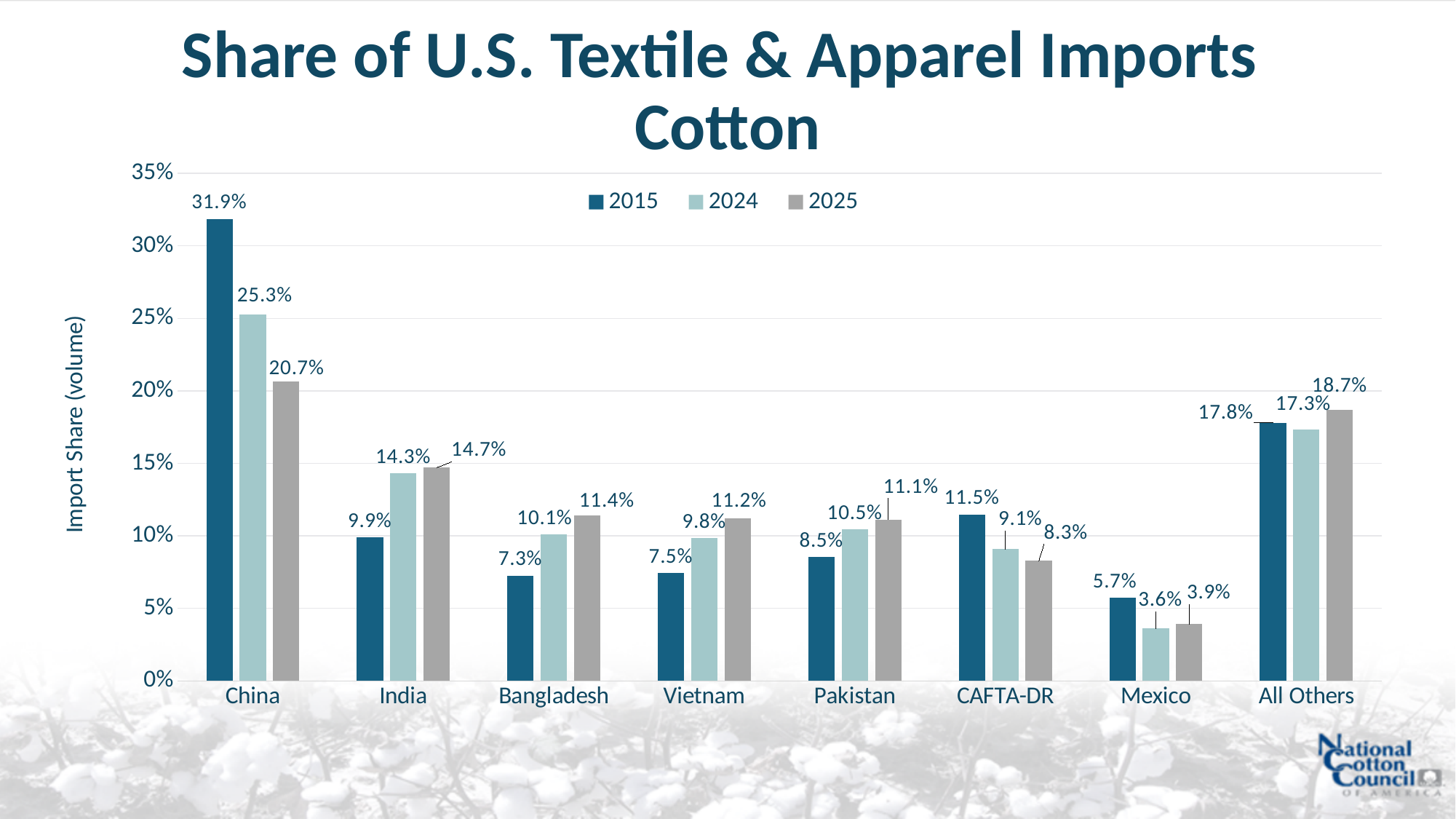
What is the label on the vertical axis? Import Share (volume) Which category has the lowest 2015 import share? Mexico Do China's import shares rise or fall from 2015 to 2025? Fall What is the difference between China's 2015 and 2025 import shares? 11.2% What is Mexico's import share for 2024? 3.6% How many series does the legend list? 3 Which category has the highest 2025 import share? China What is the 2025 import share for Bangladesh? 11.4% How many categories are shown on the x axis? 8 What is China's import share for 2015? 31.9% Which is larger, India's 2025 share or Pakistan's 2025 share? India's 2025 share What kind of chart is shown on the slide? Bar chart